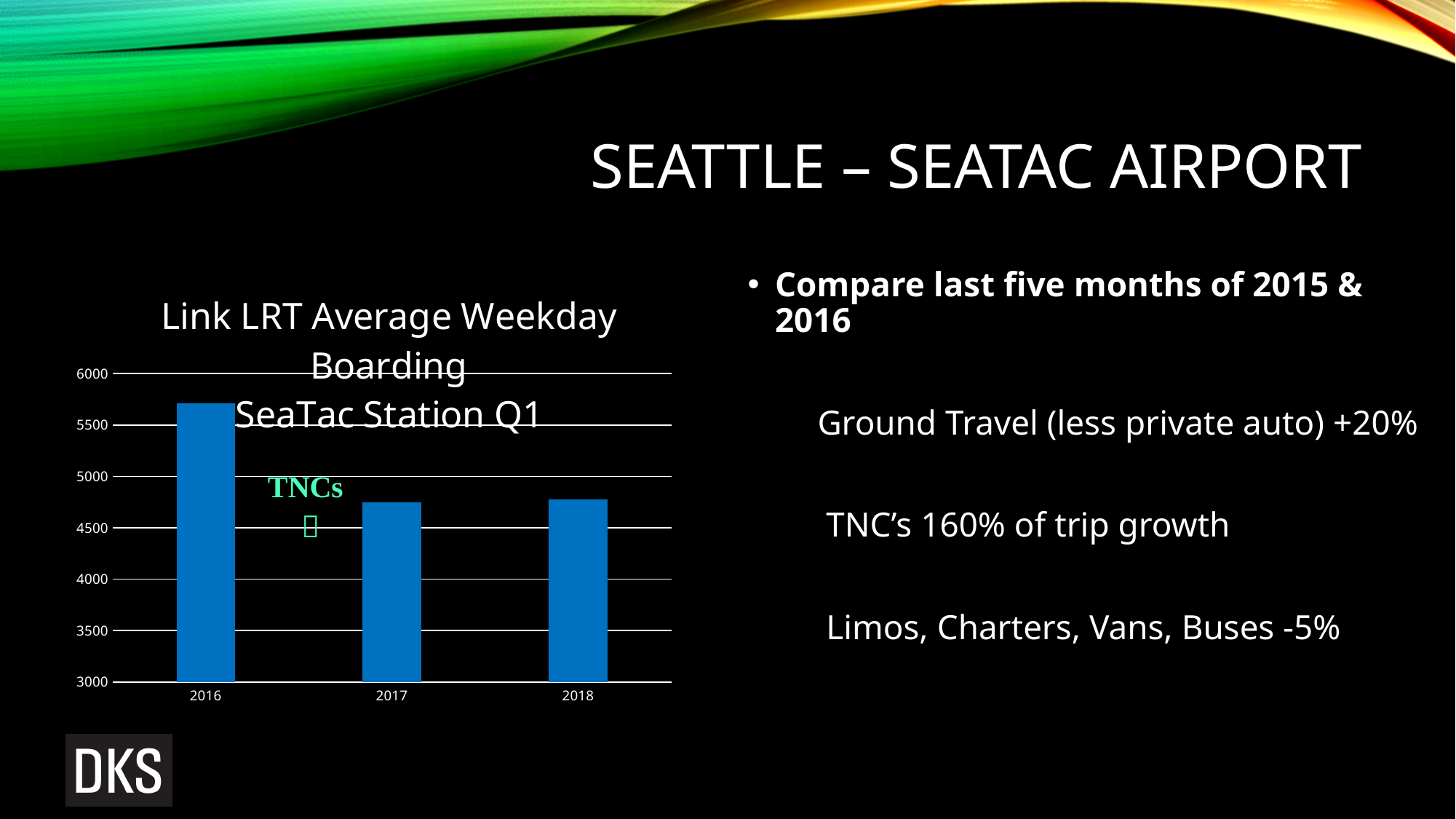
Which year has the highest average weekday boarding in the chart? 2016 Is the value for 2018 greater or less than 4500? greater Is the value for 2018 greater or less than 5000? less Is the value for 2016 greater or less than 5500? greater How many years are shown on the x axis of the chart? 3 What is the title of the chart? Link LRT Average Weekday Boarding SeaTac Station Q1 Does the value rise or fall from 2016 to 2017? fall What is the lowest value shown on the chart's y axis? 3000 What kind of chart is shown on the slide? bar chart Which is larger, the value for 2016 or the value for 2017? 2016